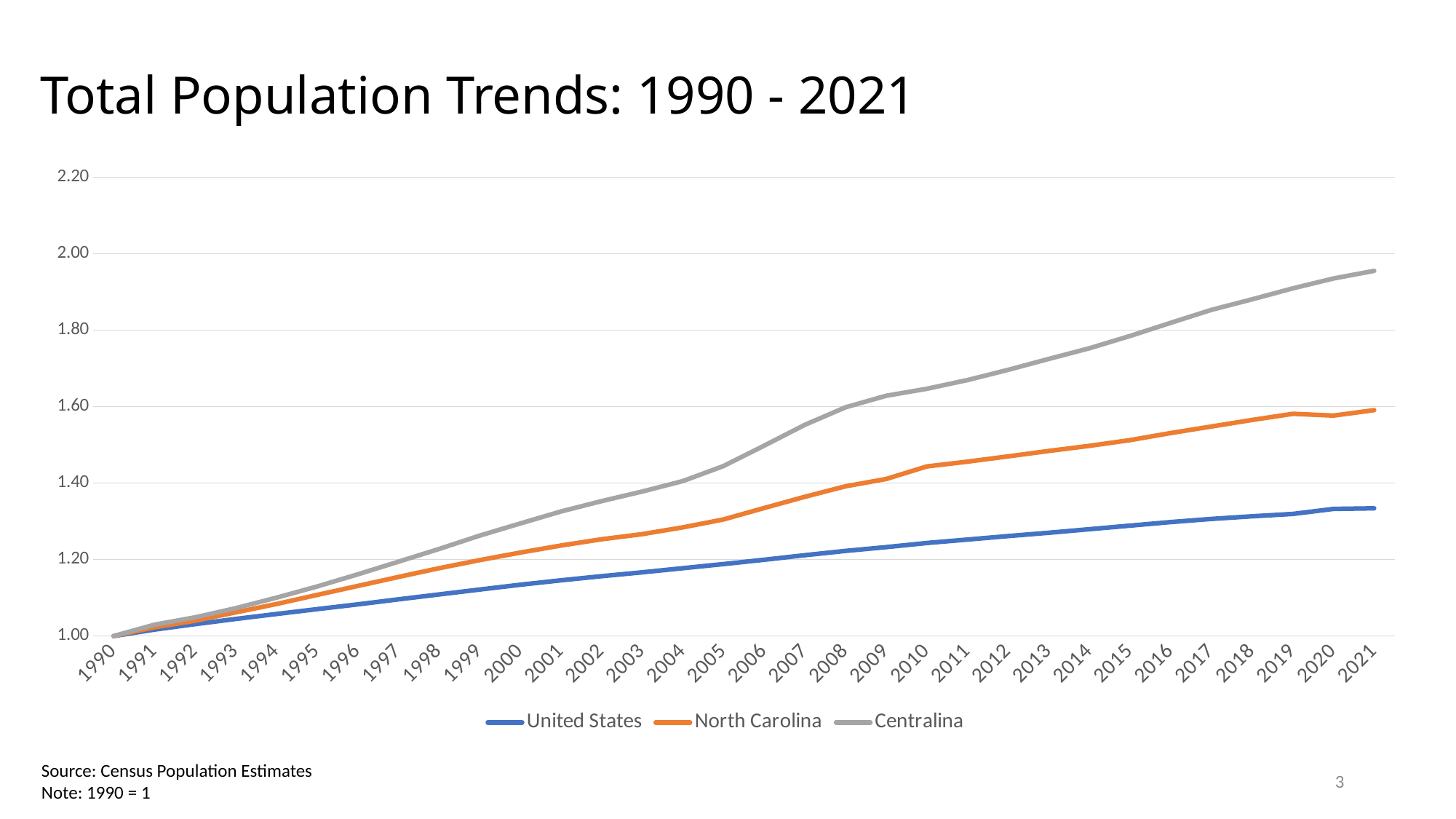
Do the values for Centralina rise or fall from 1990 to 2021? rise What is the value for Centralina in 1990? 1.00 Is the value for North Carolina in 2005 greater or less than 1.20? greater Is the value for United States in 2021 greater or less than 1.40? less Is the value for Centralina in 2021 greater or less than 1.80? greater What is the title of the chart? Total Population Trends: 1990 - 2021 Which series has the highest value in 2021? Centralina How many years are plotted along the x axis? 32 What kind of chart is shown on the slide? line chart Which series has the lowest value in 2021? United States In 2021, which is larger: the value for North Carolina or the value for United States? North Carolina How many series does the legend list? 3